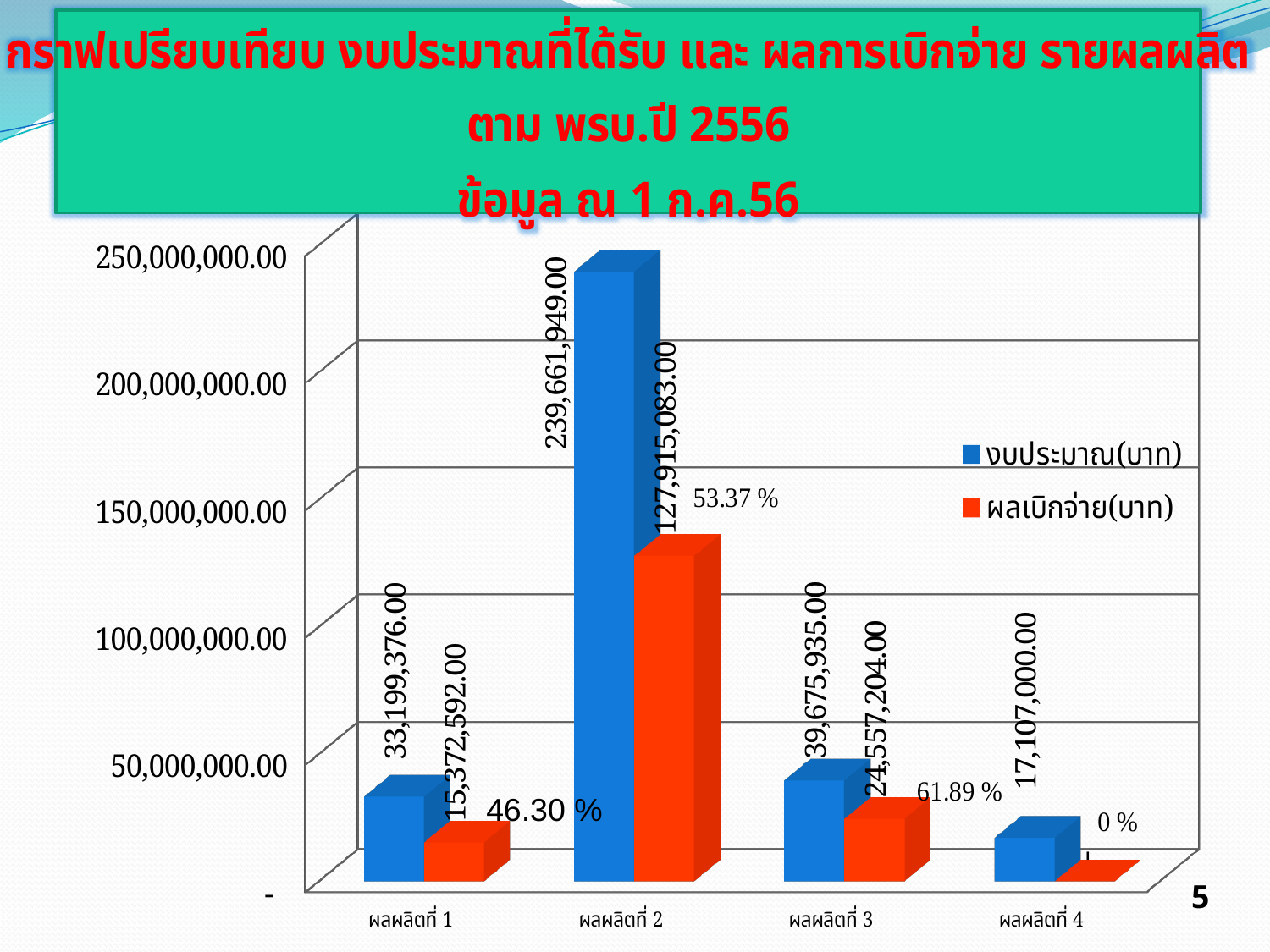
What percentage is shown above the ผลเบิกจ่าย bar for ผลผลิตที่ 3? 61.89 % What is the ผลเบิกจ่าย(บาท) value for ผลผลิตที่ 3? 24,557,204.00 How many series does the legend list? 2 What is the ผลเบิกจ่าย(บาท) value for ผลผลิตที่ 1? 15,372,592.00 What kind of chart is shown on the slide? Bar chart What is the difference between งบประมาณ(บาท) and ผลเบิกจ่าย(บาท) for ผลผลิตที่ 1? 17,826,784.00 Which category has the lowest งบประมาณ(บาท) value? ผลผลิตที่ 4 What is the งบประมาณ(บาท) value for ผลผลิตที่ 2? 239,661,949.00 How many categories are shown on the x axis? 4 Which category has the highest งบประมาณ(บาท) value? ผลผลิตที่ 2 Which is larger, the งบประมาณ(บาท) for ผลผลิตที่ 3 or the งบประมาณ(บาท) for ผลผลิตที่ 1? ผลผลิตที่ 3 What is the งบประมาณ(บาท) value for ผลผลิตที่ 4? 17,107,000.00